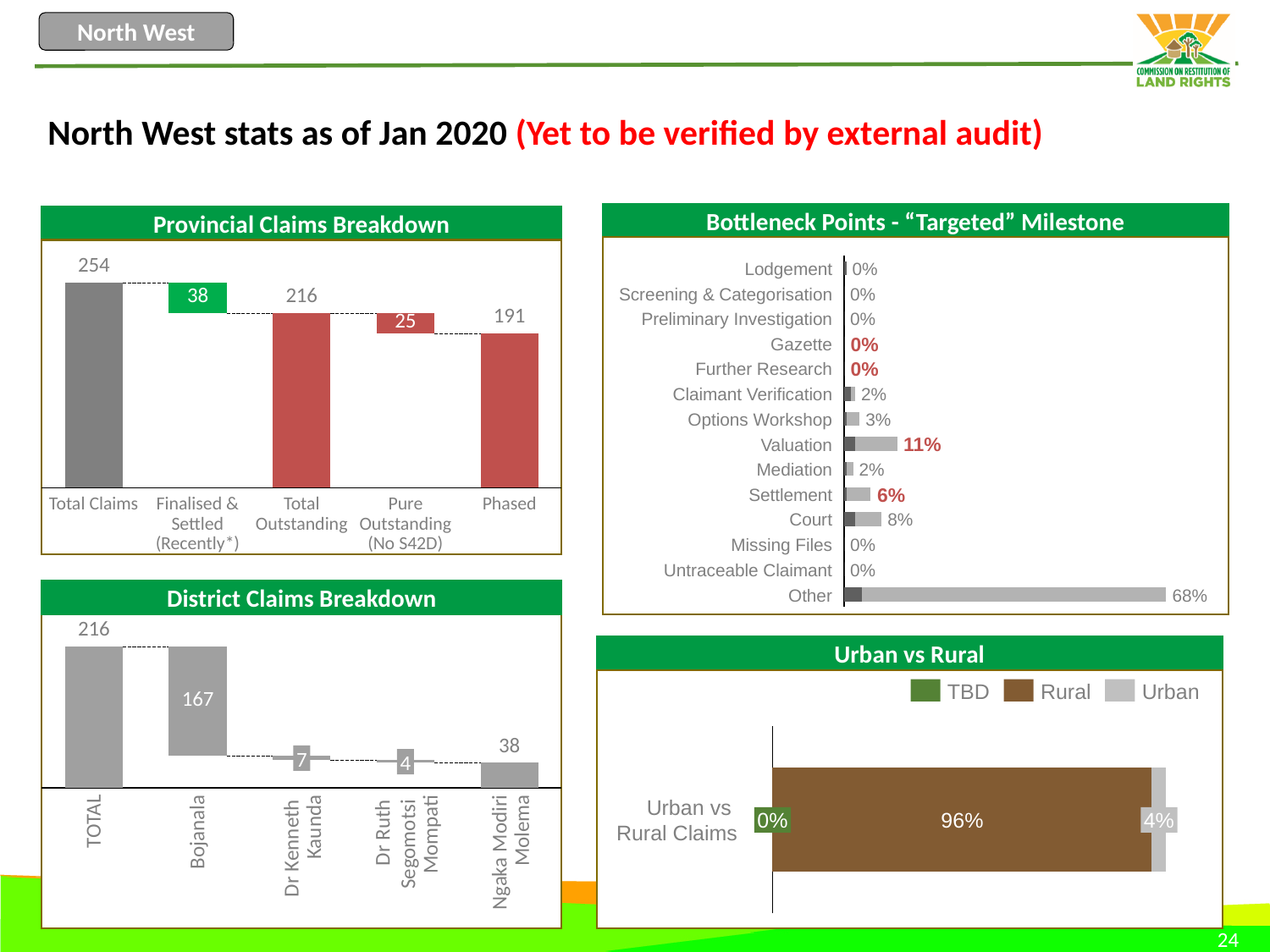
In the Provincial Claims Breakdown chart, what is the difference between Total Claims and Total Outstanding? 38 How many series does the legend of the Urban vs Rural chart list? 3 In the Urban vs Rural chart, what is the value for Rural? 96% In the Bottleneck Points - "Targeted" Milestone chart, which category has the highest value? Other In the Provincial Claims Breakdown chart, what is the value for Total Claims? 254 In the Bottleneck Points - "Targeted" Milestone chart, what is the value for Valuation? 11% In the Provincial Claims Breakdown chart, what is the value for Phased? 191 In the District Claims Breakdown chart, what is the value for Ngaka Modiri Molema? 38 In the Bottleneck Points - "Targeted" Milestone chart, which is larger, Court or Settlement? Court In the District Claims Breakdown chart, which district has the highest value? Bojanala How many categories are shown on the x axis of the Provincial Claims Breakdown chart? 5 In the District Claims Breakdown chart, which district has the lowest value? Dr Ruth Segomotsi Mompati